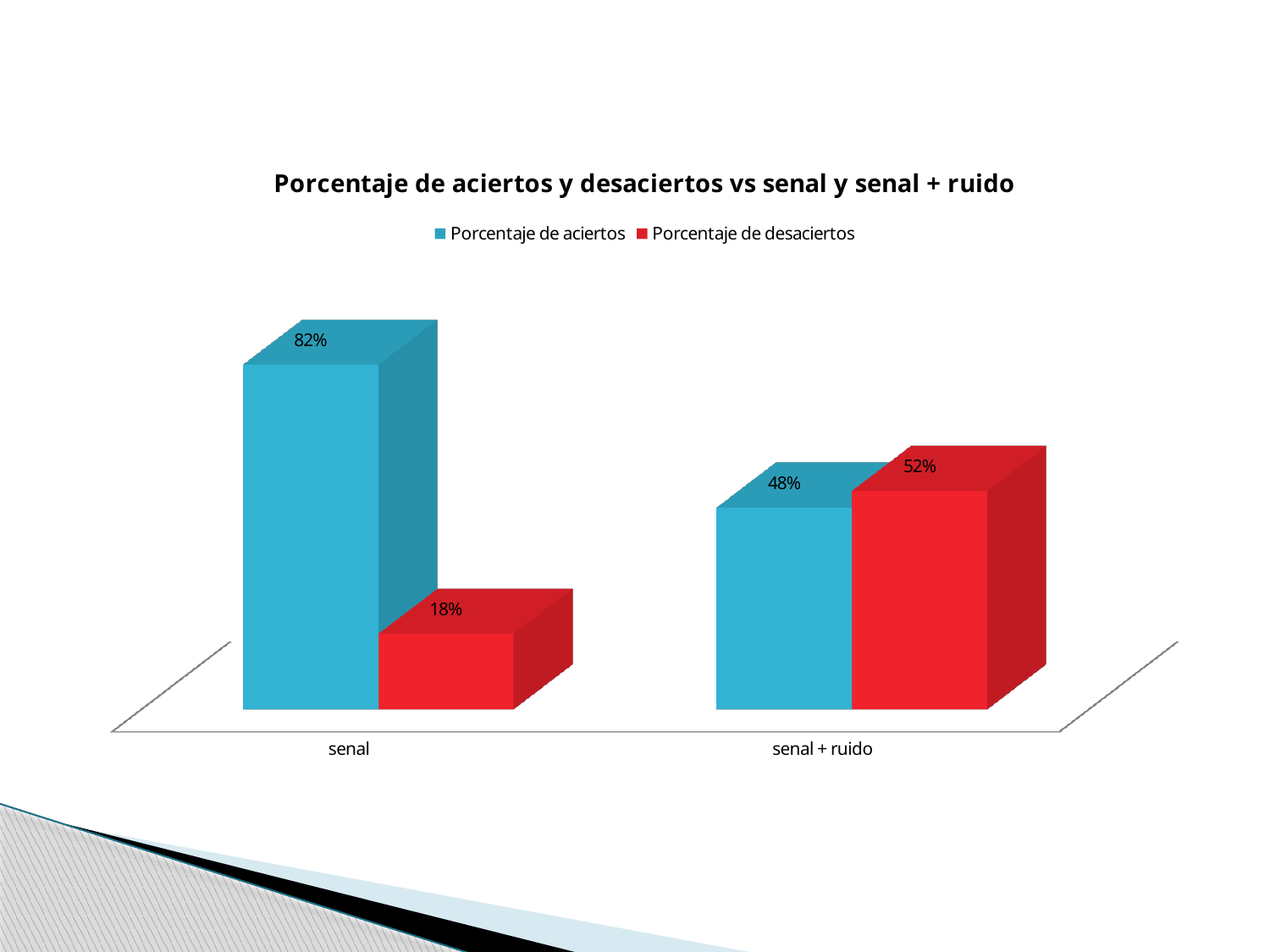
How many series does the legend list? 2 What kind of chart is shown on the slide? Bar chart For senal + ruido, which is larger: Porcentaje de aciertos or Porcentaje de desaciertos? Porcentaje de desaciertos What is the Porcentaje de aciertos for senal? 82% Which category has the lowest Porcentaje de desaciertos? senal What is the difference between Porcentaje de desaciertos and Porcentaje de aciertos for senal + ruido? 4% Which category has the highest Porcentaje de aciertos? senal How many categories are shown on the x axis? 2 What is the Porcentaje de aciertos for senal + ruido? 48% What is the Porcentaje de desaciertos for senal? 18% What is the Porcentaje de desaciertos for senal + ruido? 52% What is the difference between the Porcentaje de aciertos for senal and for senal + ruido? 34%